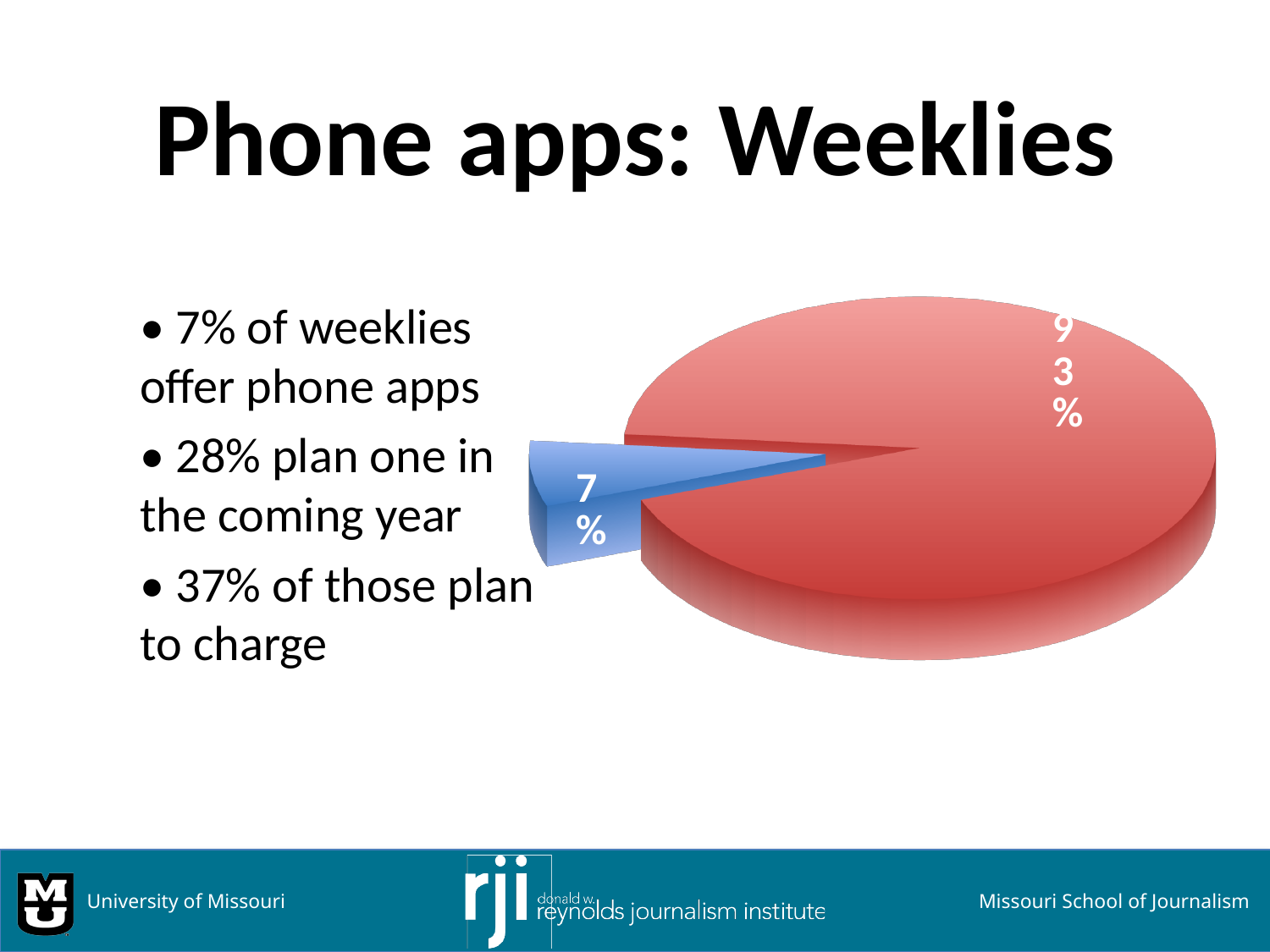
Which slice of the pie chart is pulled out (exploded) from the rest of the pie? the blue 7% slice What is the difference between the red slice and the blue slice of the pie chart? 86% What is the title of the slide containing the pie chart? Phone apps: Weeklies Which slice of the pie chart is the smallest? the blue slice (7%) What value is labelled on the red slice of the pie chart? 93% What kind of chart is shown on the slide? pie chart What value is labelled on the blue slice of the pie chart? 7% Which slice of the pie chart is the largest? the red slice (93%) Which is larger in the pie chart, the red slice or the blue slice? the red slice What share of the pie does the blue slice represent? 7% What do the two slices of the pie chart add up to? 100% How many slices does the pie chart have? 2